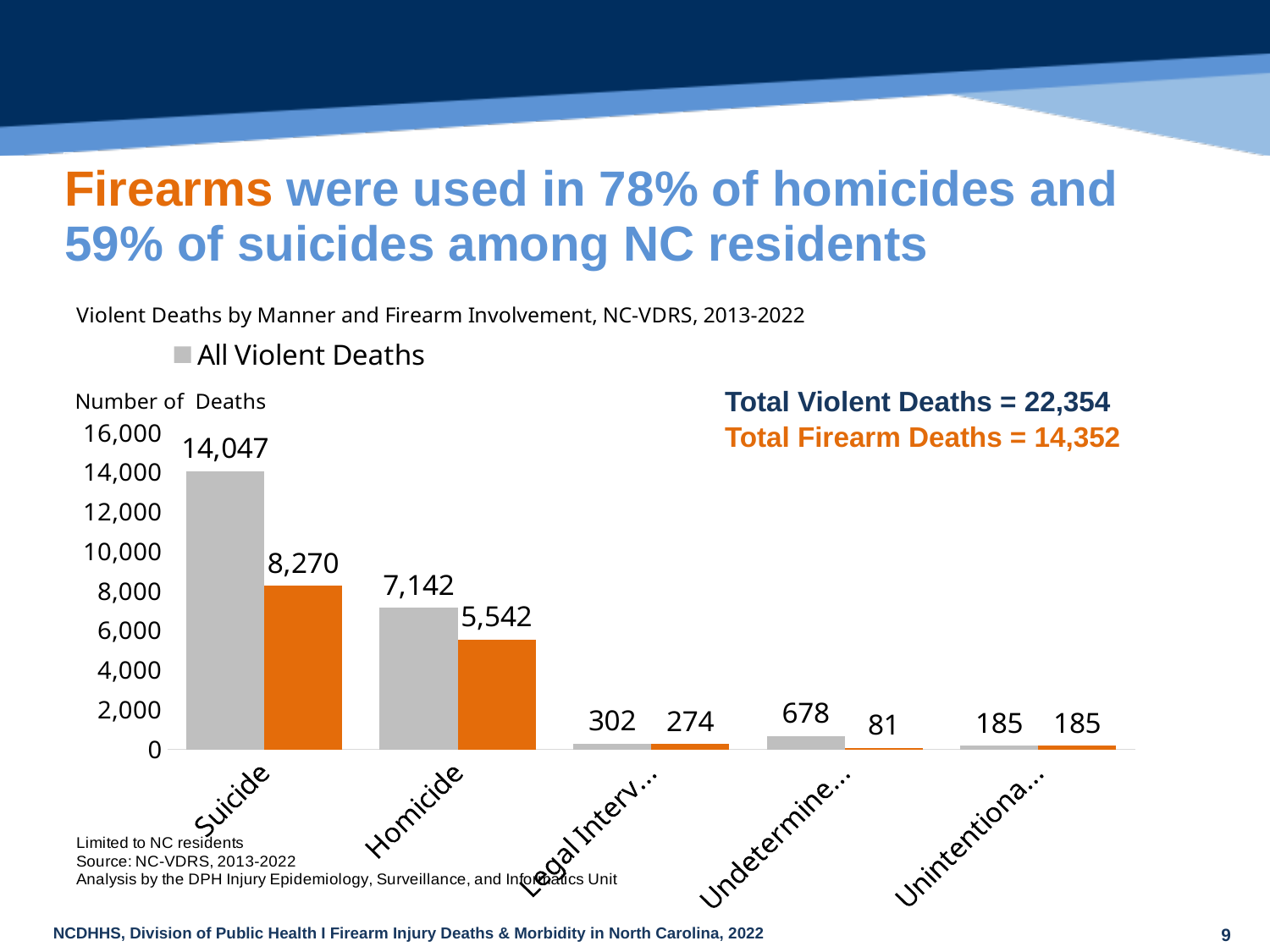
Which manner of death has the highest number of All Violent Deaths? Suicide What is the value of the All Violent Deaths bar for Suicide? 14,047 Is the All Violent Deaths value for Suicide greater or less than 12,000? greater What is the value of the orange (firearm) bar for Homicide? 5,542 What is the difference between the All Violent Deaths bar and the orange (firearm) bar for Homicide? 1,600 What is the value of the All Violent Deaths bar for Unintentional? 185 What is the value of the orange (firearm) bar for Undetermined? 81 Which manner of death has the lowest number of All Violent Deaths? Unintentional Which has more All Violent Deaths, Undetermined or Legal Intervention? Undetermined How many manner-of-death categories are shown on the x axis? 5 What is the difference between the All Violent Deaths bar and the orange (firearm) bar for Suicide? 5,777 What type of chart is shown on the slide? Bar chart